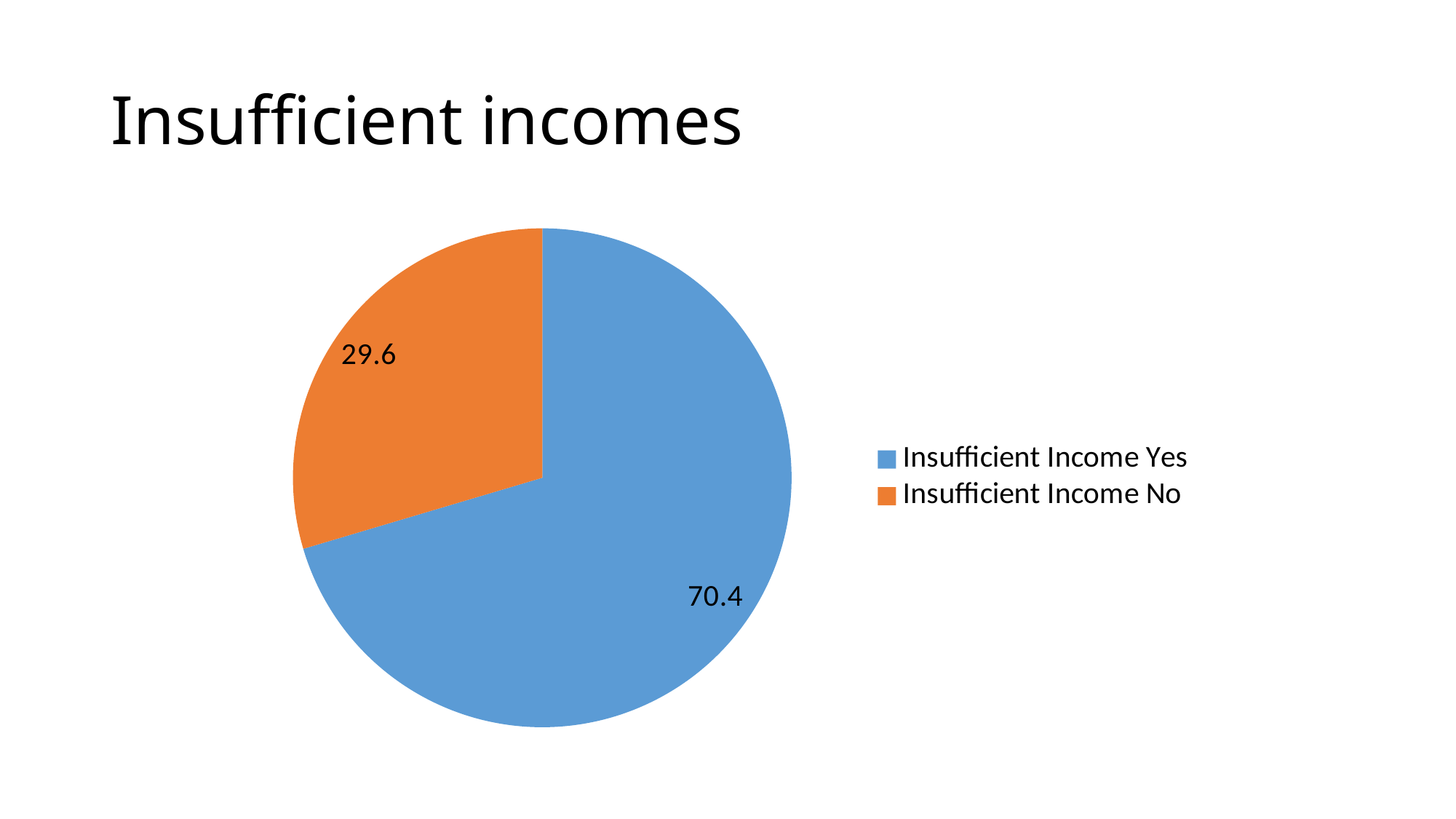
Which category has the smallest slice of the pie? Insufficient Income No How many slices does the pie chart have? 2 What colour is the slice for Insufficient Income No? orange What is the difference between the values for Insufficient Income Yes and Insufficient Income No? 40.8 Which category has the largest slice of the pie? Insufficient Income Yes What kind of chart is shown on the slide? pie chart What is the value for Insufficient Income Yes? 70.4 What is the value for Insufficient Income No? 29.6 How many entries does the legend list? 2 What is the title of the slide? Insufficient incomes Which is larger, the value for Insufficient Income Yes or Insufficient Income No? Insufficient Income Yes What is the total of the two slice values shown on the pie chart? 100